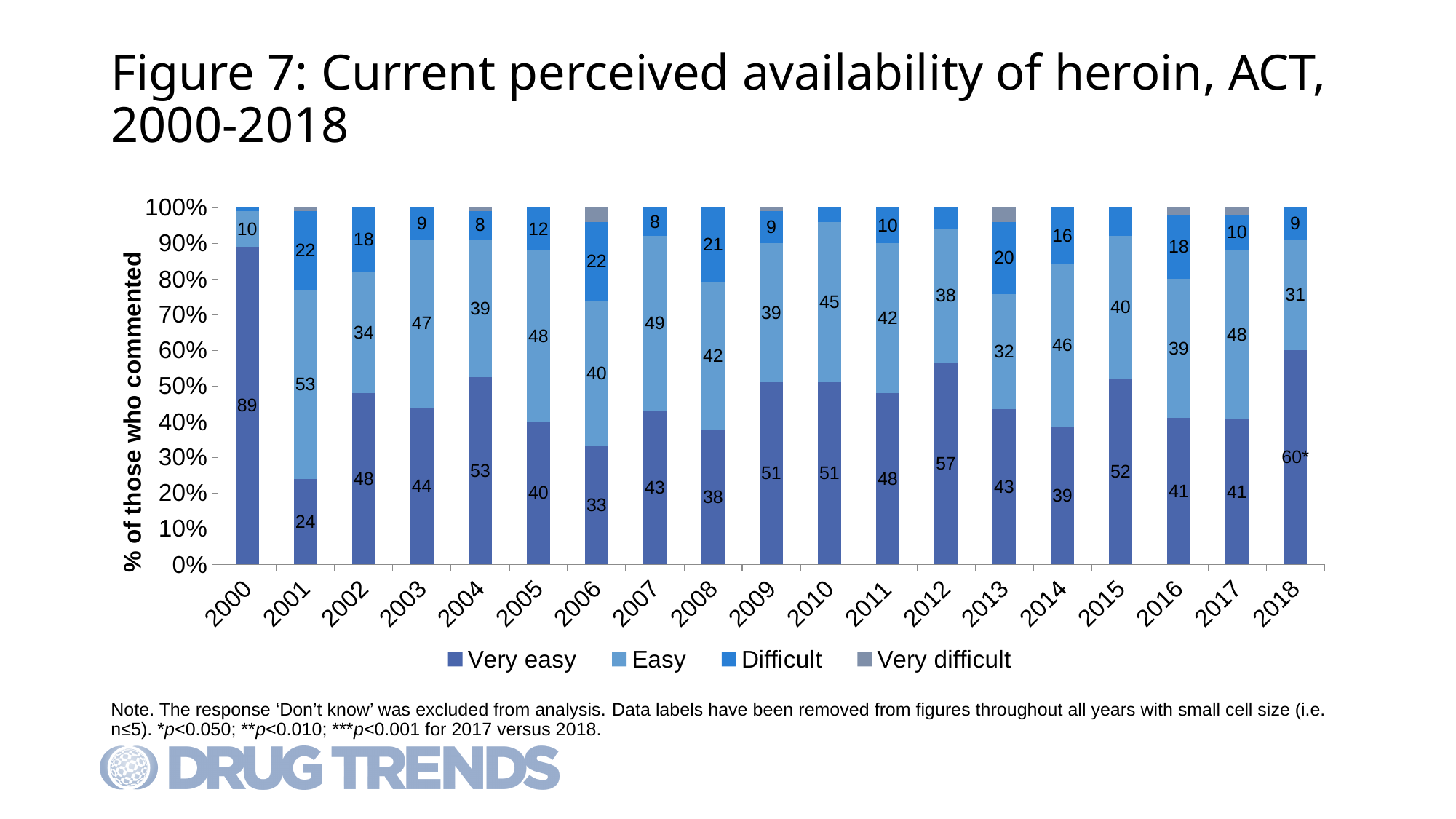
What is the difference between the 'Very easy' values for 2012 and 2013? 14 What is the label on the y axis? % of those who commented What is the 'Very easy' value for 2001? 24 What is the 'Difficult' value for 2013? 20 In which year is the 'Very easy' value lowest? 2001 How many series does the legend list? 4 In which year is the 'Very easy' value highest? 2000 How many years are shown on the x axis? 19 Which is larger, the 'Easy' value for 2010 or the 'Easy' value for 2018? 2010 What is the 'Easy' value for 2007? 49 What is the 'Very easy' value for 2018? 60* What type of chart is shown on the slide? Stacked bar chart